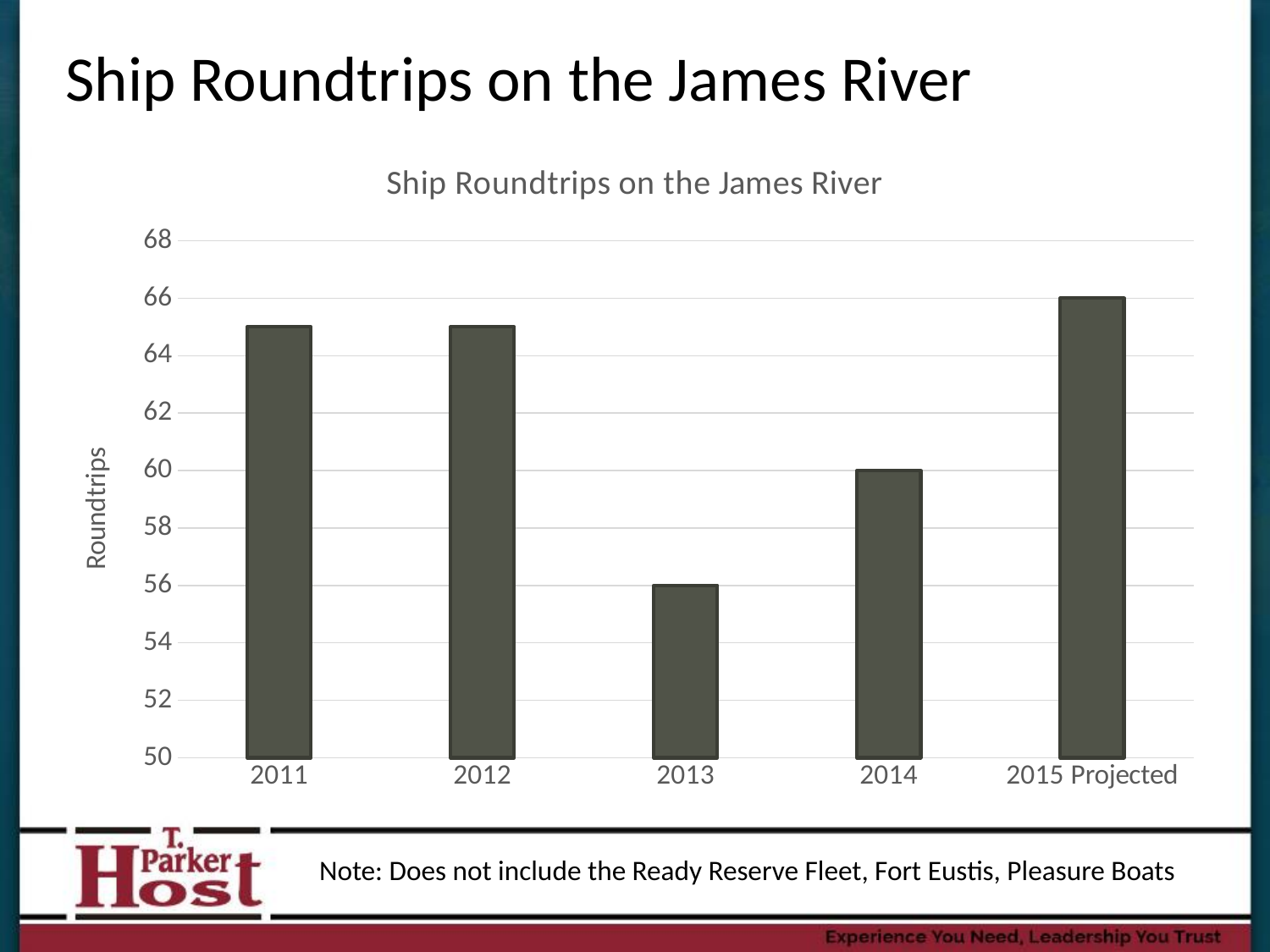
Which category has the highest number of roundtrips? 2015 Projected Which year has the lowest number of roundtrips? 2013 How many categories are shown on the x axis? 5 Is the value for 2011 greater or less than 64? greater What is the value for 2014? 60 What is the difference between the values for 2015 Projected and 2014? 6 What is the difference between the values for 2014 and 2013? 4 What is the value for 2015 Projected? 66 Which is larger, the value for 2011 or the value for 2013? 2011 What kind of chart is shown? bar chart Is the value for 2012 greater or less than 66? less What is the value for 2013? 56